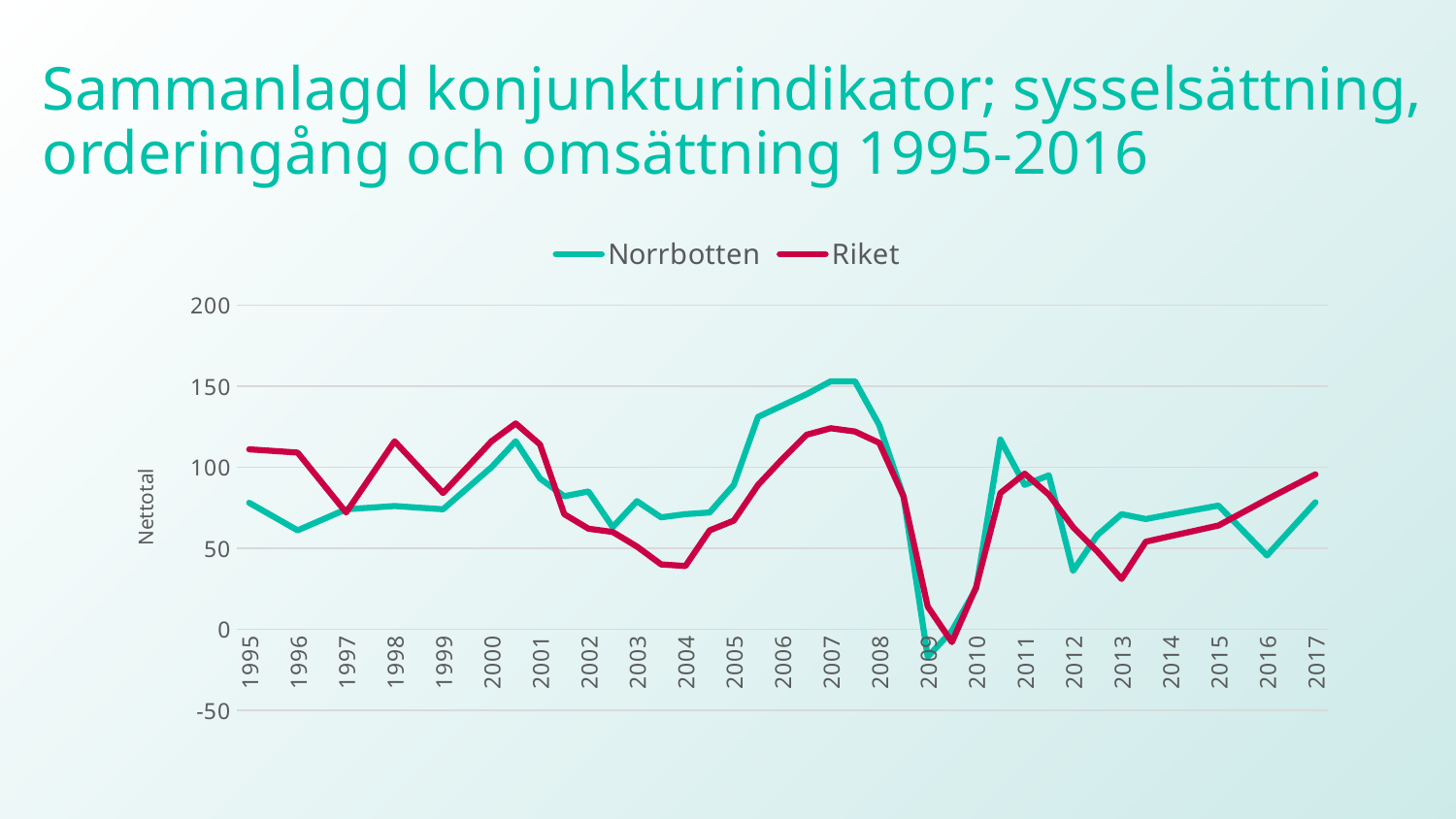
What kind of chart is shown on the slide? line chart How many years are labelled along the x axis? 23 How many series does the legend list? 2 What is the label on the vertical axis? Nettotal Is the value for Norrbotten in 2007 greater or less than 100? greater What are the two series named in the legend? Norrbotten and Riket In which year does the Norrbotten series reach its highest value? 2007 In which year does the Norrbotten series reach its lowest value? 2009 Which series has the higher value in 1998, Norrbotten or Riket? Riket Is the value for Norrbotten in 2009 greater or less than 0? less Does the Riket series rise or fall between 2000 and 2004? fall